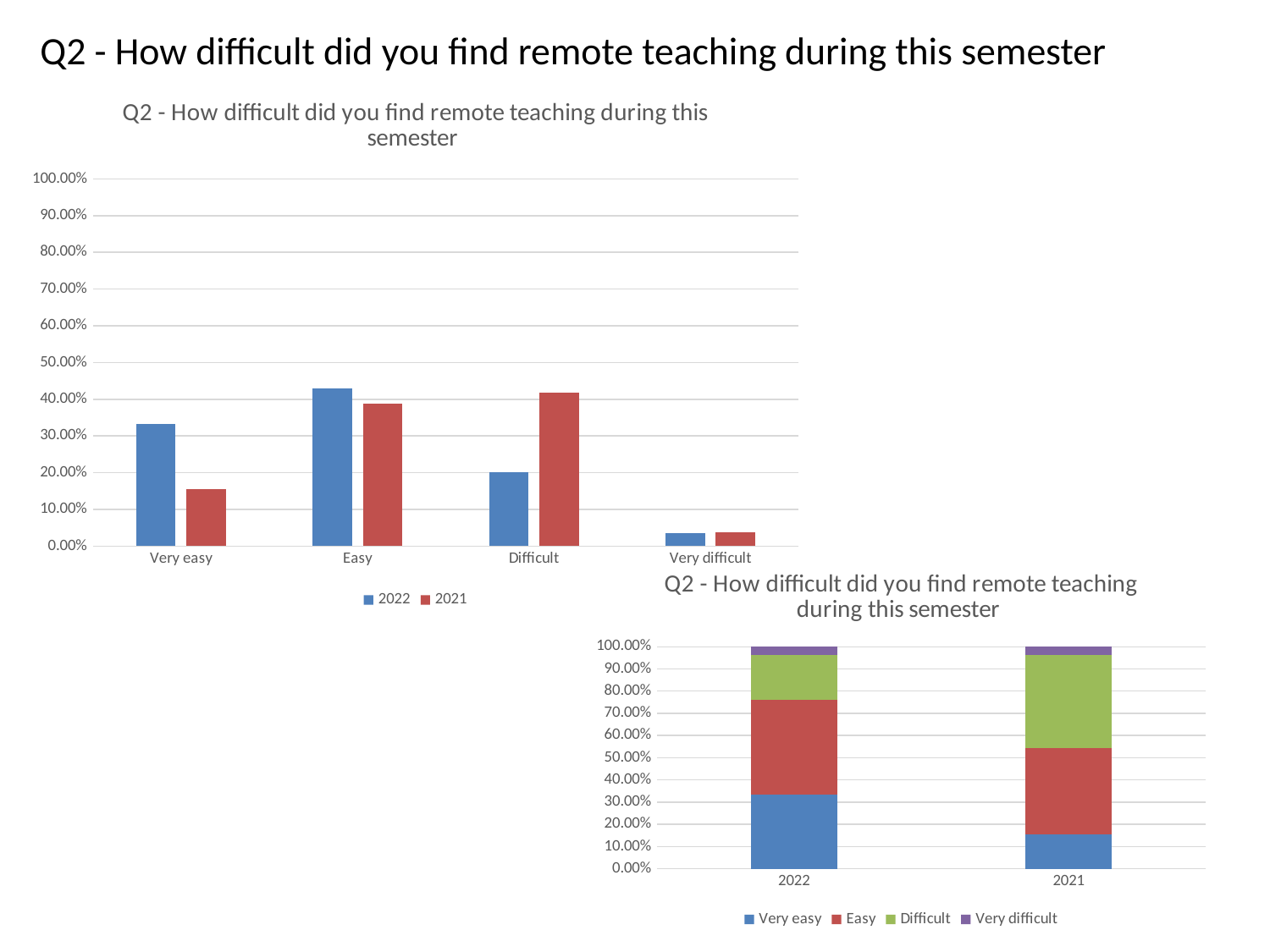
In the top-left chart, which category has the highest value for 2022? Easy In the top-left chart, how many categories are shown on the x axis? 4 In the top-left chart, which category has the lowest value for 2022? Very difficult In the top-left chart, is the 2022 value for Easy greater or less than 40.00%? greater In the bottom-right chart, how many series does the legend list? 4 In the top-left chart, which category has the highest value for 2021? Difficult In the top-left chart, for the Very easy category, which year has the larger value, 2022 or 2021? 2022 What type of chart is the top-left chart on the slide? Bar chart In the top-left chart, is the 2021 value for Very easy greater or less than 20.00%? less In the bottom-right chart, how many bars are shown on the x axis? 2 In the top-left chart, how many series does the legend list? 2 In the bottom-right chart, which legend entry is shown in green? Difficult